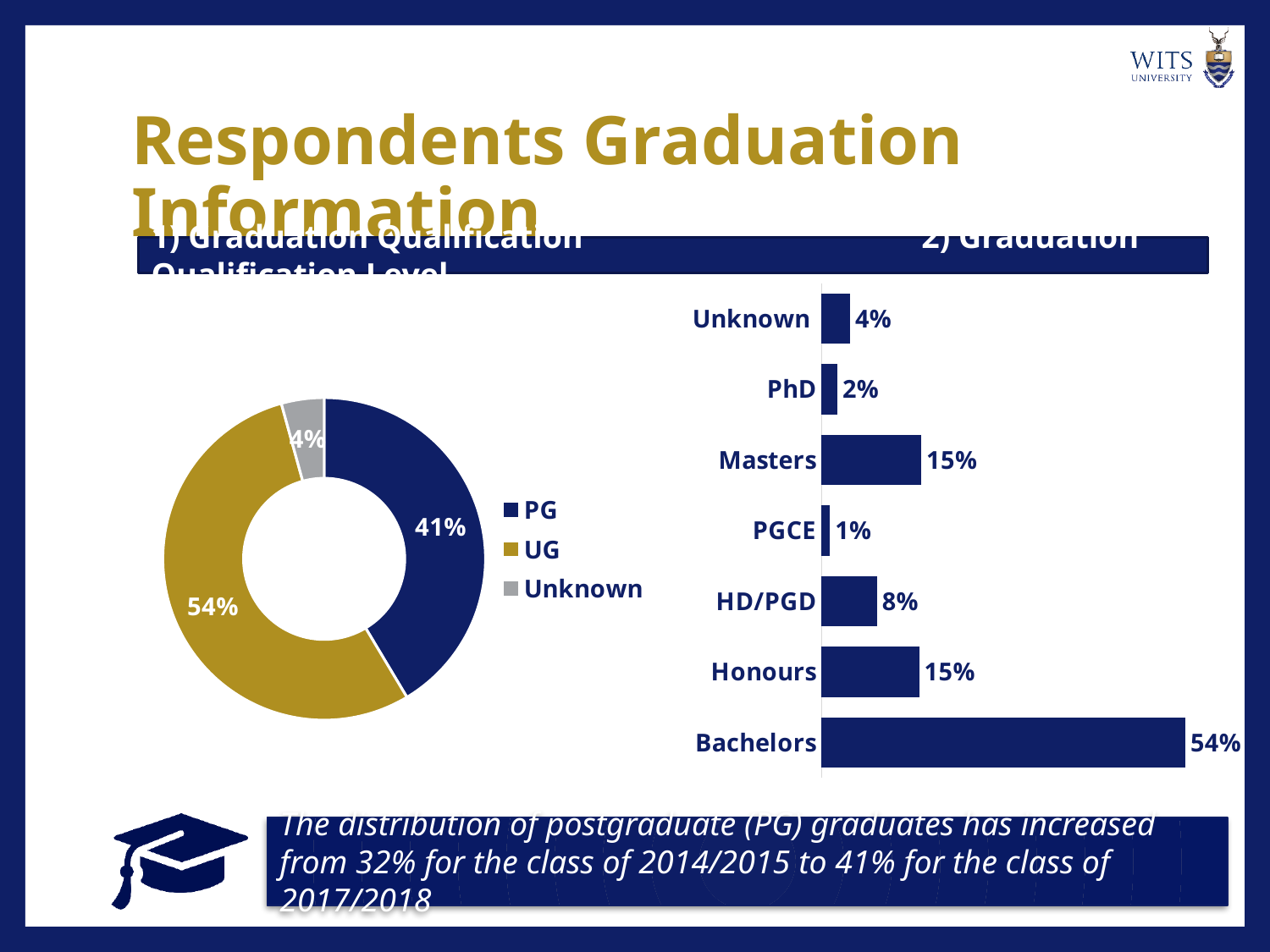
In the bar chart on the right, which is larger: the value for PhD or the value for HD/PGD? HD/PGD In the bar chart on the right, which category has the highest value? Bachelors In the doughnut chart on the left, what percentage is shown for UG? 54% In the doughnut chart on the left, what is the difference between the UG and PG percentages? 13% In the doughnut chart on the left, which category has the smallest share? Unknown In the doughnut chart on the left, how many entries does the legend list? 3 In the bar chart on the right, which category has the lowest value? PGCE In the doughnut chart on the left, what percentage is shown for PG? 41% What type of chart is shown on the right side of the slide? Bar chart In the bar chart on the right, what percentage is shown for Masters? 15% In the bar chart on the right, what percentage is shown for HD/PGD? 8% In the bar chart on the right, how many categories are shown? 7